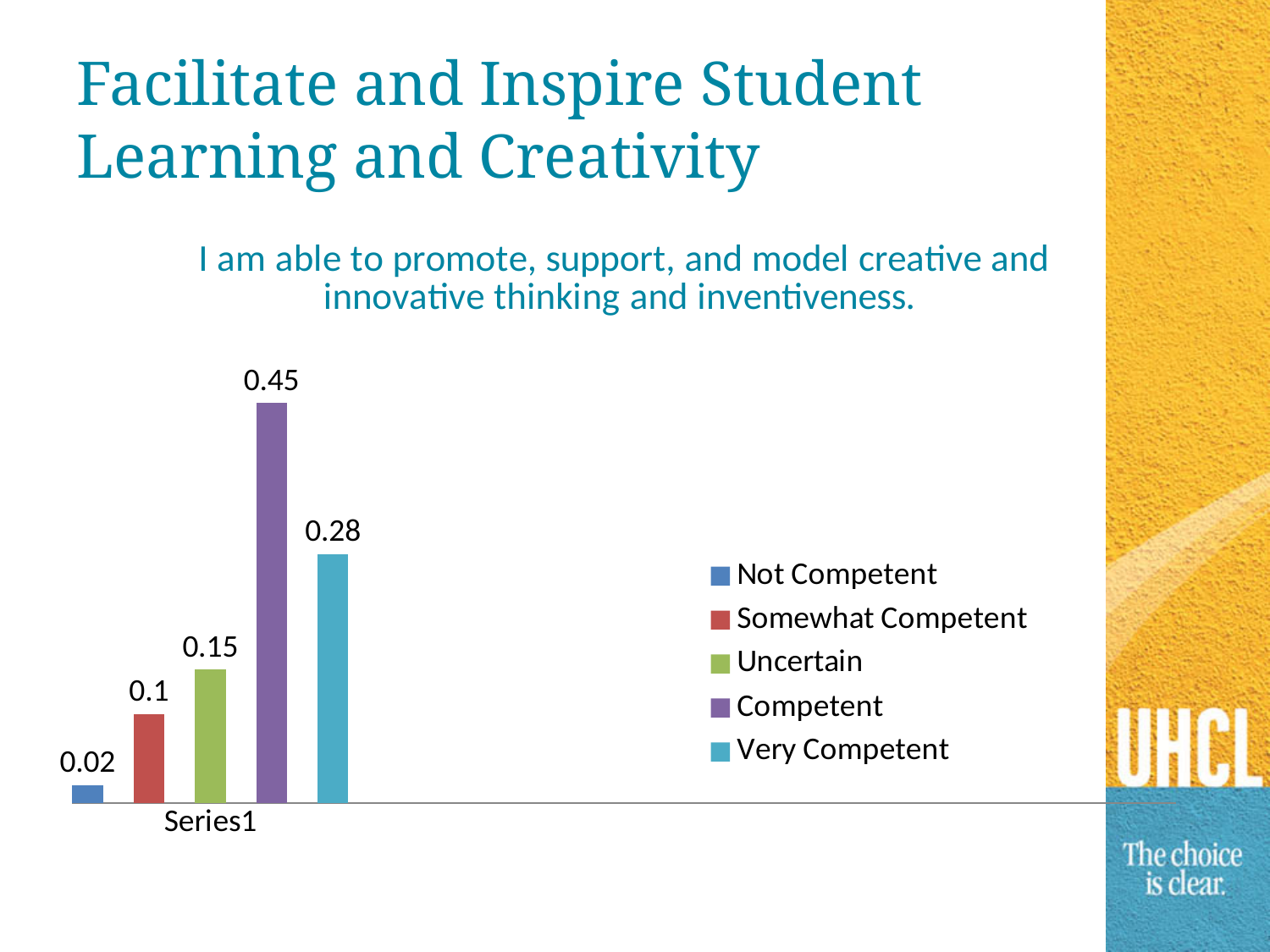
What is the value for Competent? 0.45 What is the value for Uncertain? 0.15 Which is larger, the value for Somewhat Competent or the value for Uncertain? Uncertain What is the value for Very Competent? 0.28 How many series does the legend list? 5 What is the difference between the values for Competent and Very Competent? 0.17 What is the total of the values for Competent and Very Competent? 0.73 What is the value for Not Competent? 0.02 What kind of chart is shown on the slide? Bar chart Which category has the lowest value? Not Competent What colour is the bar for Competent? Purple Which category has the highest value? Competent